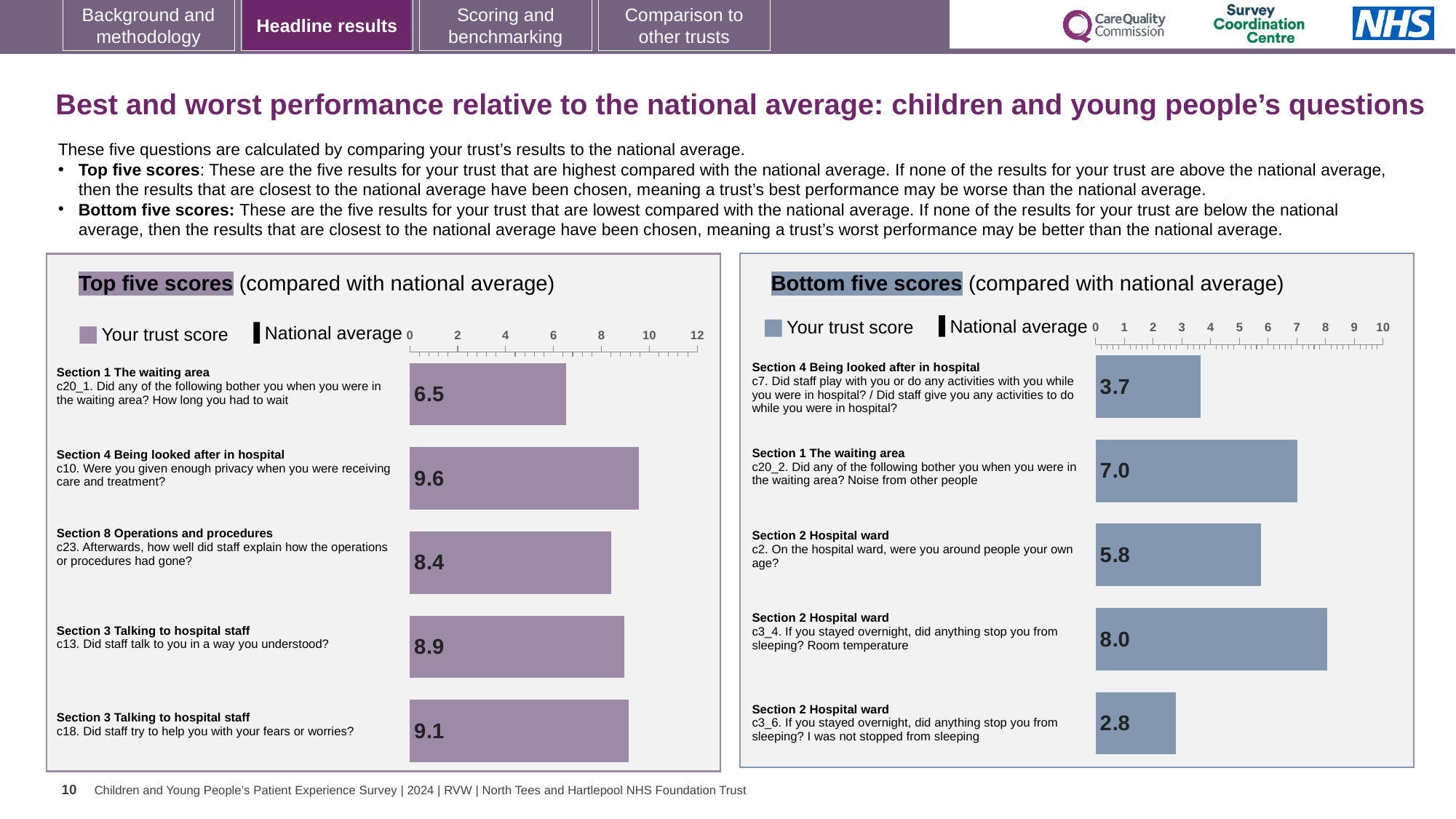
In the Bottom five scores chart, what is the trust score for c3_6 (I was not stopped from sleeping)? 2.8 In the Top five scores chart, what is the trust score for c20_1 (How long you had to wait in the waiting area)? 6.5 In the Top five scores chart, which question has the highest trust score? c10. Were you given enough privacy when you were receiving care and treatment? In the Bottom five scores chart, what is the trust score for c2 (On the hospital ward, were you around people your own age)? 5.8 In the Bottom five scores chart, which question has the highest trust score? c3_4. If you stayed overnight, did anything stop you from sleeping? Room temperature In the Top five scores chart, what is the trust score for c10 (Were you given enough privacy when you were receiving care and treatment)? 9.6 In the Bottom five scores chart, which question has the lowest trust score? c3_6. If you stayed overnight, did anything stop you from sleeping? I was not stopped from sleeping How many questions are shown in the Bottom five scores chart? 5 In the Top five scores chart, what is the difference between the trust scores for c18 and c13? 0.2 What type of chart is the Top five scores chart? Bar chart In the Bottom five scores chart, what is the difference between the trust scores for c20_2 and c7? 3.3 In the Top five scores chart, which has the larger trust score: c23 or c13? c13